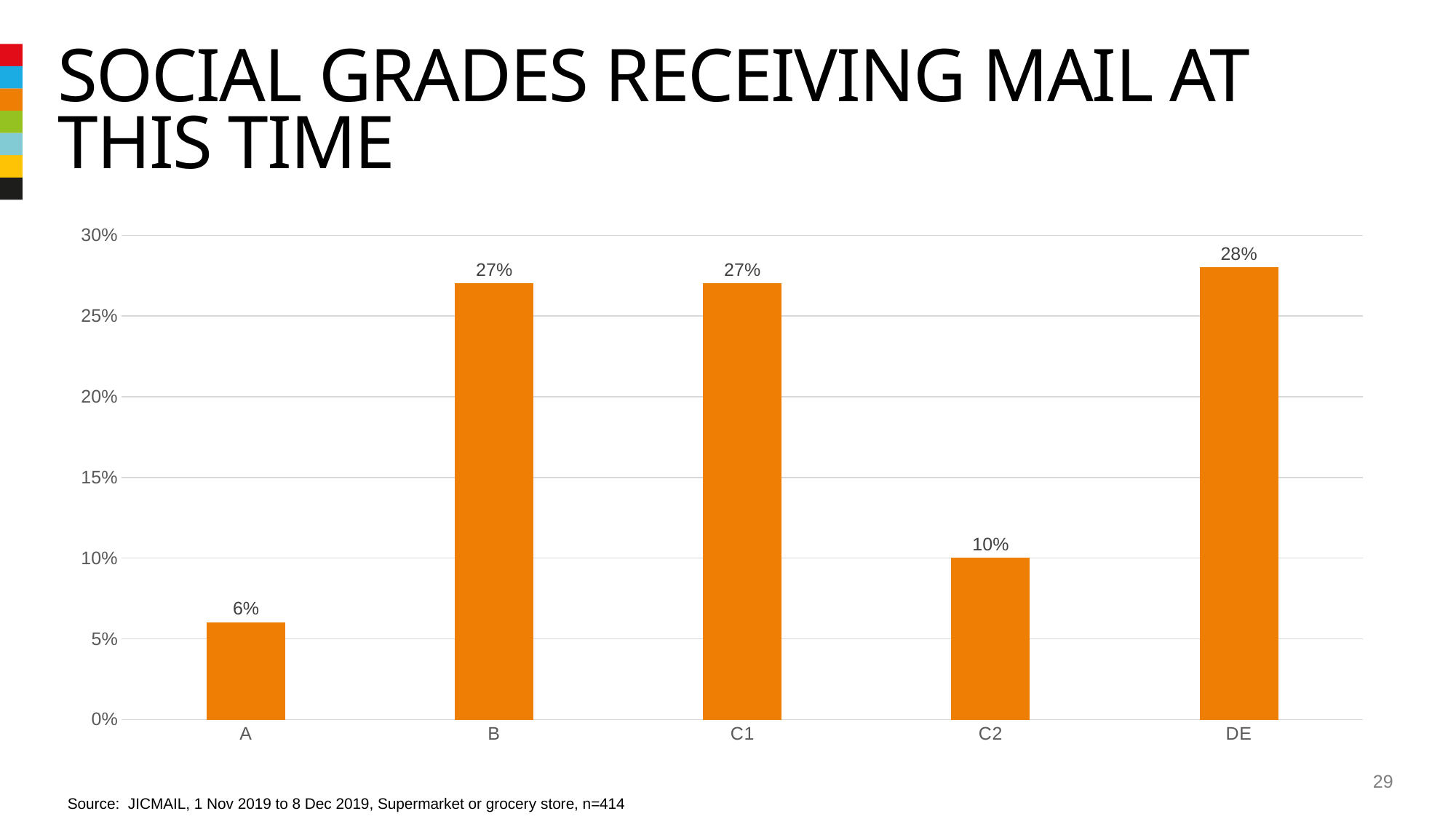
What kind of chart is shown on the slide? Bar chart Which social grade has the lowest value? A What is the value for social grade A? 6% How many social grades are shown on the x axis? 5 What is the difference between the values for C1 and C2? 17% What is the value for social grade B? 27% What is the difference between the values for DE and A? 22% Which social grade has the highest value? DE What is the value for social grade C2? 10% What is the title of the chart on the slide? Social grades receiving mail at this time What is the value for social grade DE? 28% Which is larger, the value for B or the value for C2? B